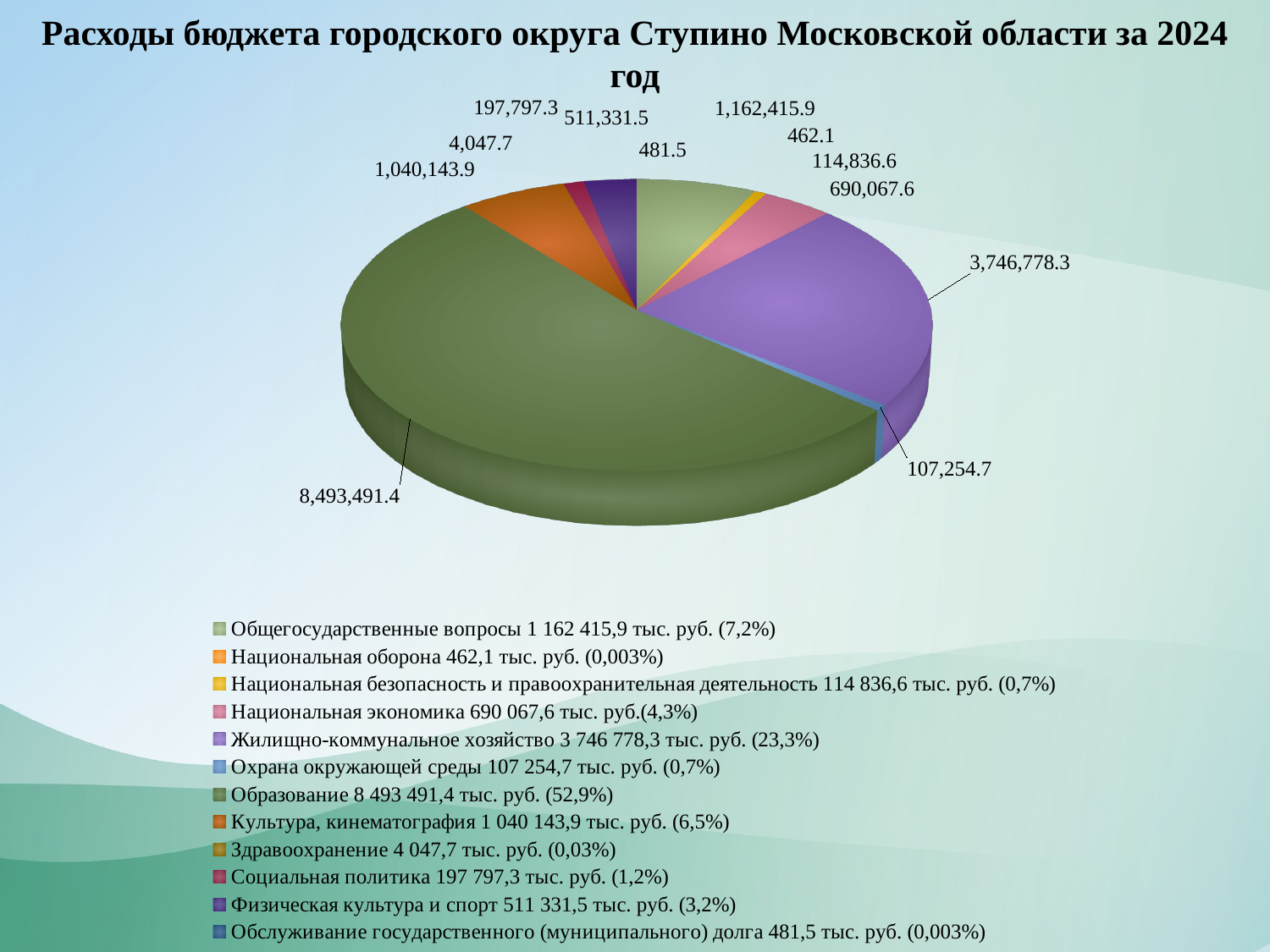
What share of the pie does Жилищно-коммунальное хозяйство account for, according to the legend? 23,3% What share of the pie does Образование account for, according to the legend? 52,9% Which category has the smallest value in the pie chart? Национальная оборона Which is larger: Общегосударственные вопросы or Культура, кинематография? Общегосударственные вопросы How many categories (slices) does the pie chart have? 12 What is the value shown for Культура, кинематография? 1,040,143.9 What is the value shown for Охрана окружающей среды? 107,254.7 Which category has the largest slice in the pie chart? Образование What is the difference between the values for Жилищно-коммунальное хозяйство and Общегосударственные вопросы? 2,584,362.4 What kind of chart is shown on the slide? Pie chart What is the title of the chart? Расходы бюджета городского округа Ступино Московской области за 2024 год What is the value shown for Жилищно-коммунальное хозяйство? 3,746,778.3